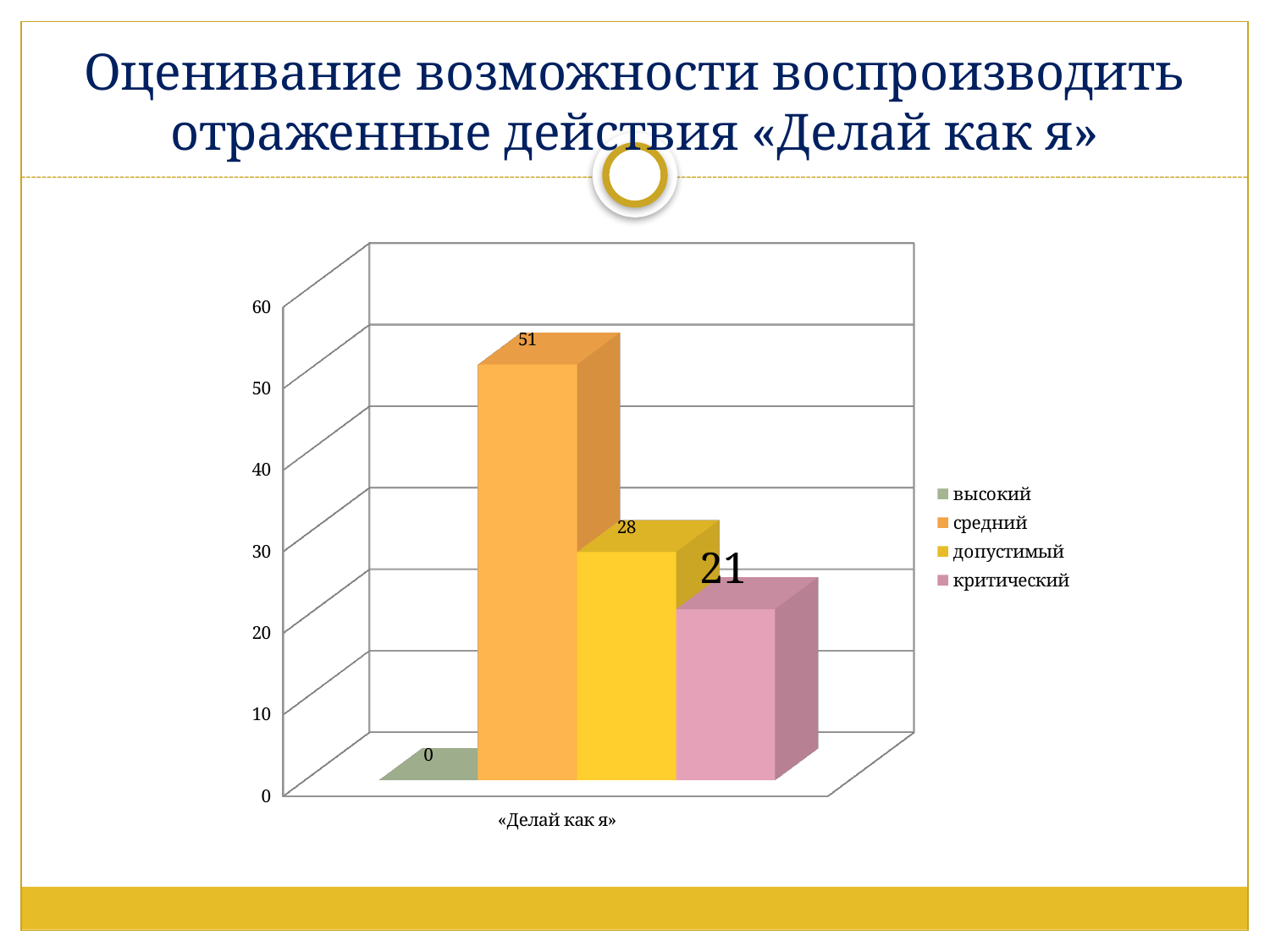
What is the value for the series «средний» in the chart? 51 What kind of chart is shown on the slide? bar chart Which is larger, the value for «допустимый» or the value for «критический»? допустимый Which series has the lowest value in the chart? высокий What is the value for the series «высокий» in the chart? 0 What is the value for the series «критический» in the chart? 21 How many series does the legend list? 4 Which series has the highest value in the chart? средний What is the difference between the values for «средний» and «допустимый»? 23 What is the category label shown on the x axis of the chart? «Делай как я» What is the difference between the values for «допустимый» and «критический»? 7 What is the value for the series «допустимый» in the chart? 28